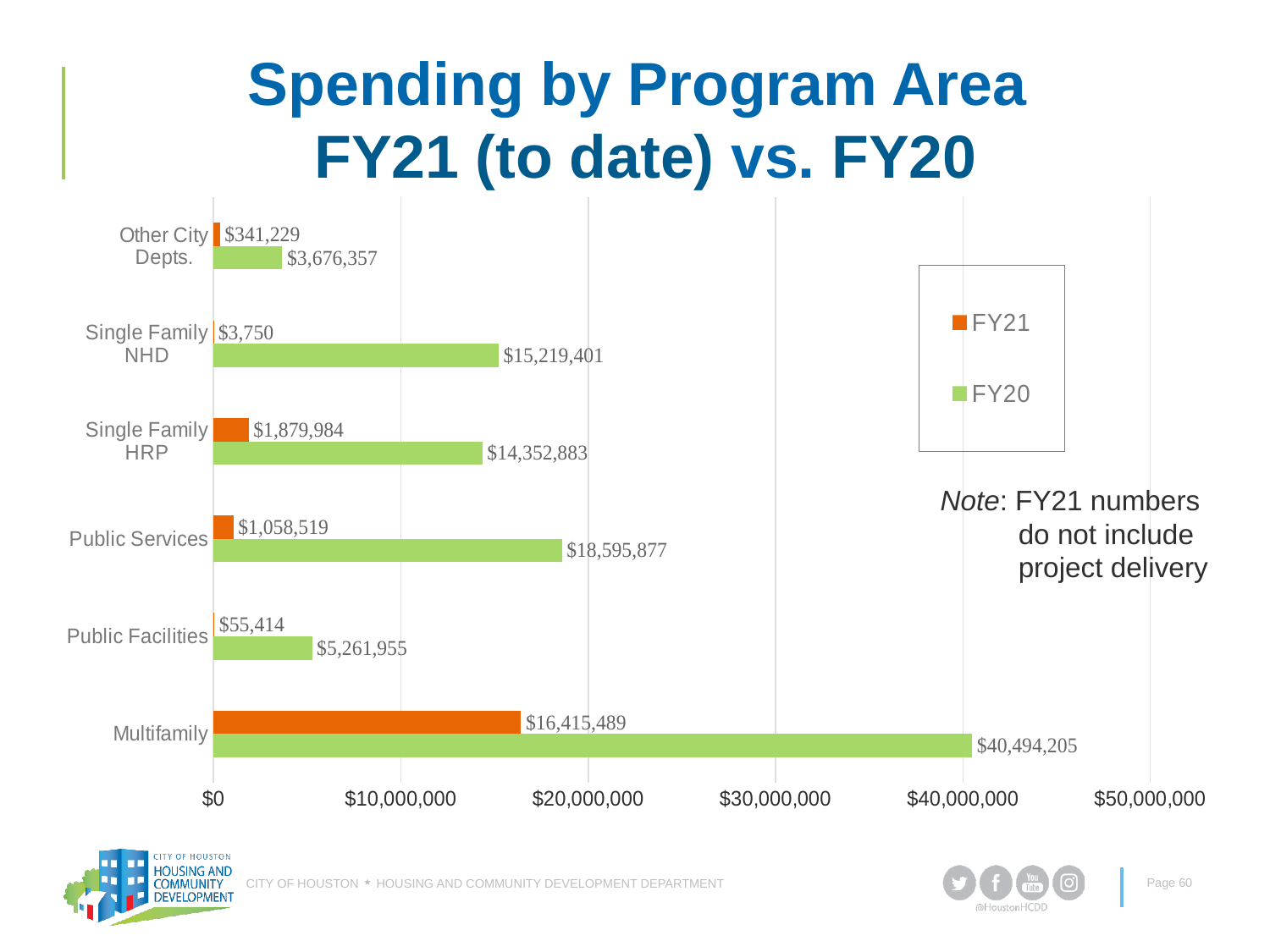
How many program areas (categories) are shown on the chart? 6 Which colour represents the FY21 series in the chart? Orange How many series does the legend list? 2 What is the FY21 spending for Single Family NHD? $3,750 What is the difference between FY20 and FY21 spending for Multifamily? $24,078,716 What is the FY21 spending for Public Services? $1,058,519 Which is larger: FY20 spending for Single Family NHD or FY20 spending for Single Family HRP? FY20 spending for Single Family NHD What is the FY20 spending for Multifamily? $40,494,205 What is the FY20 spending for Public Facilities? $5,261,955 What kind of chart is shown on the slide? Bar chart Which program area has the highest FY21 spending? Multifamily Which program area has the lowest FY20 spending? Other City Depts.